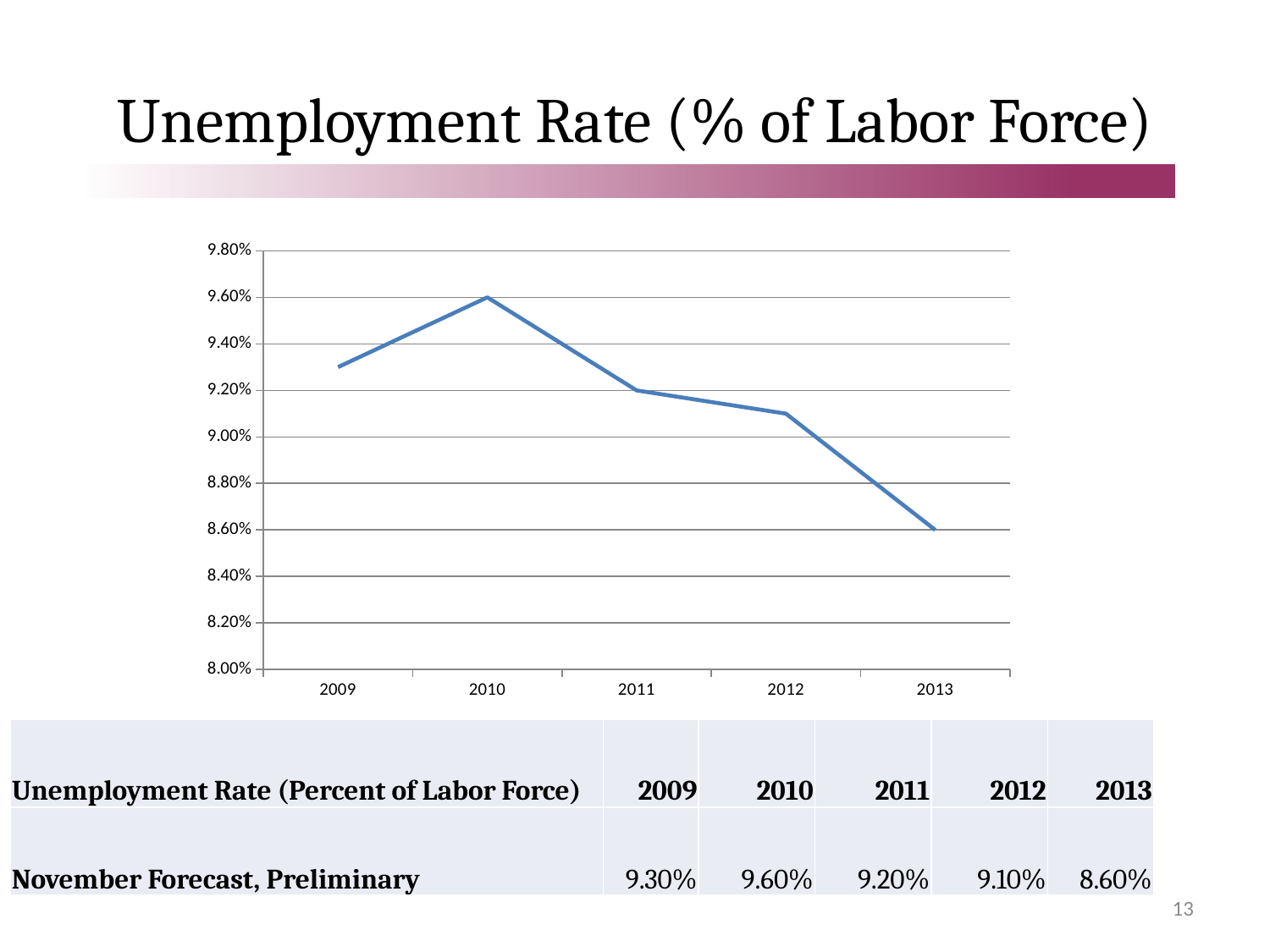
What is the unemployment rate for 2013? 8.60% How many years are plotted on the chart? 5 What is the difference between the unemployment rate in 2010 and in 2013? 1.00% What is the unemployment rate for 2009? 9.30% What is the unemployment rate for 2010? 9.60% Which year has the lowest unemployment rate? 2013 What is the title of the slide? Unemployment Rate (% of Labor Force) What type of chart is shown on the slide? line chart Which year has the highest unemployment rate? 2010 Which year has a higher unemployment rate, 2009 or 2011? 2009 Is the unemployment rate for 2012 greater or less than 9.00%? greater Does the unemployment rate rise or fall from 2010 to 2013? fall